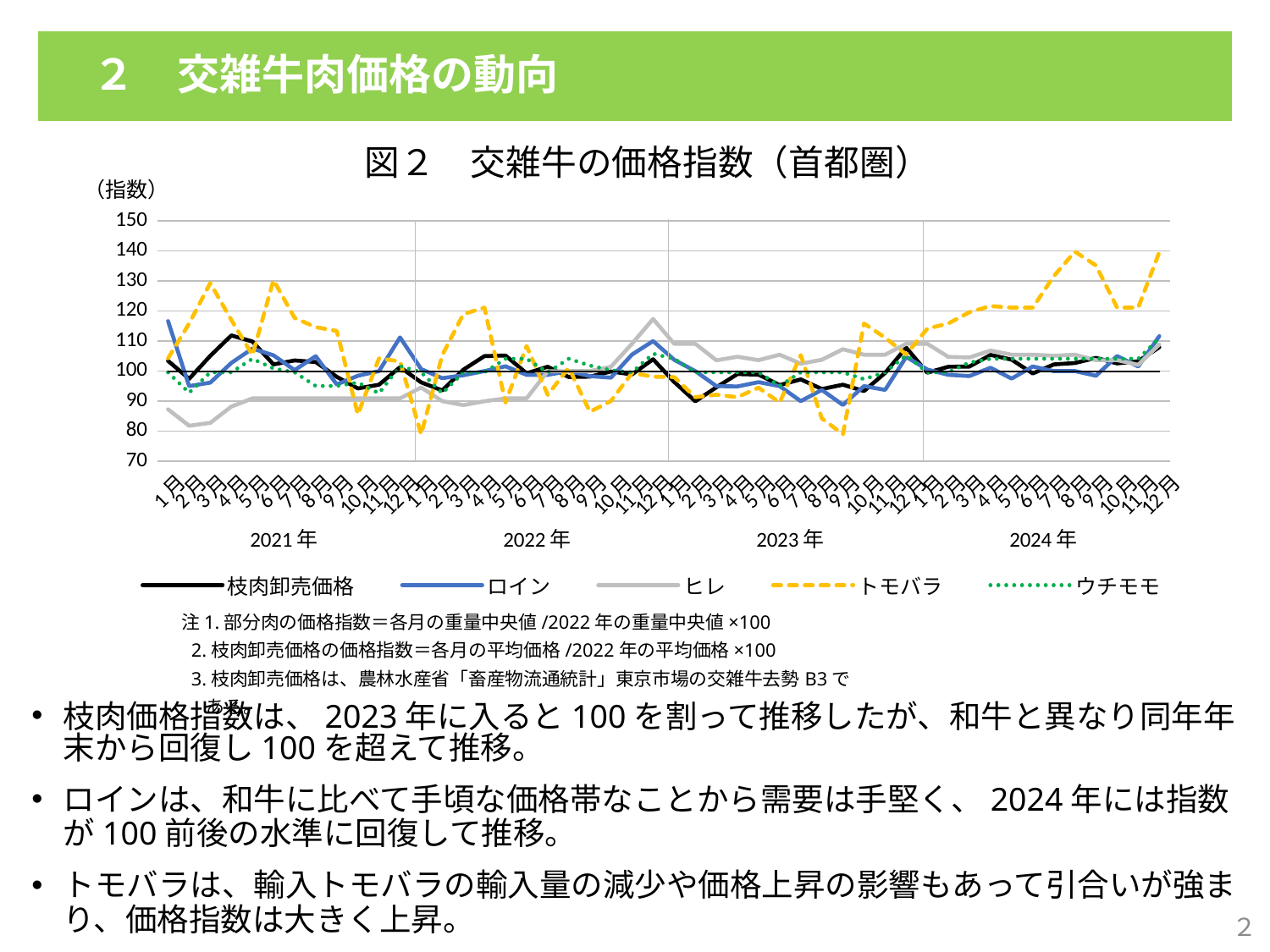
Is the value for トモバラ in 2024年12月 greater or less than 130? greater How many series does the legend list? 5 What kind of chart is shown on the slide? line chart What is the title of the chart? 図２ 交雑牛の価格指数（首都圏） Is the value for ヒレ in 2022年12月 greater or less than 110? greater How many years does the x axis cover? 4 Does the トモバラ series rise or fall over the course of 2024? rise Which series has the highest value in 2024年12月? トモバラ Which series has the lowest value in 2021年2月? ヒレ Is the value for トモバラ in 2023年9月 greater or less than 90? less Which series is drawn with a yellow dashed line? トモバラ